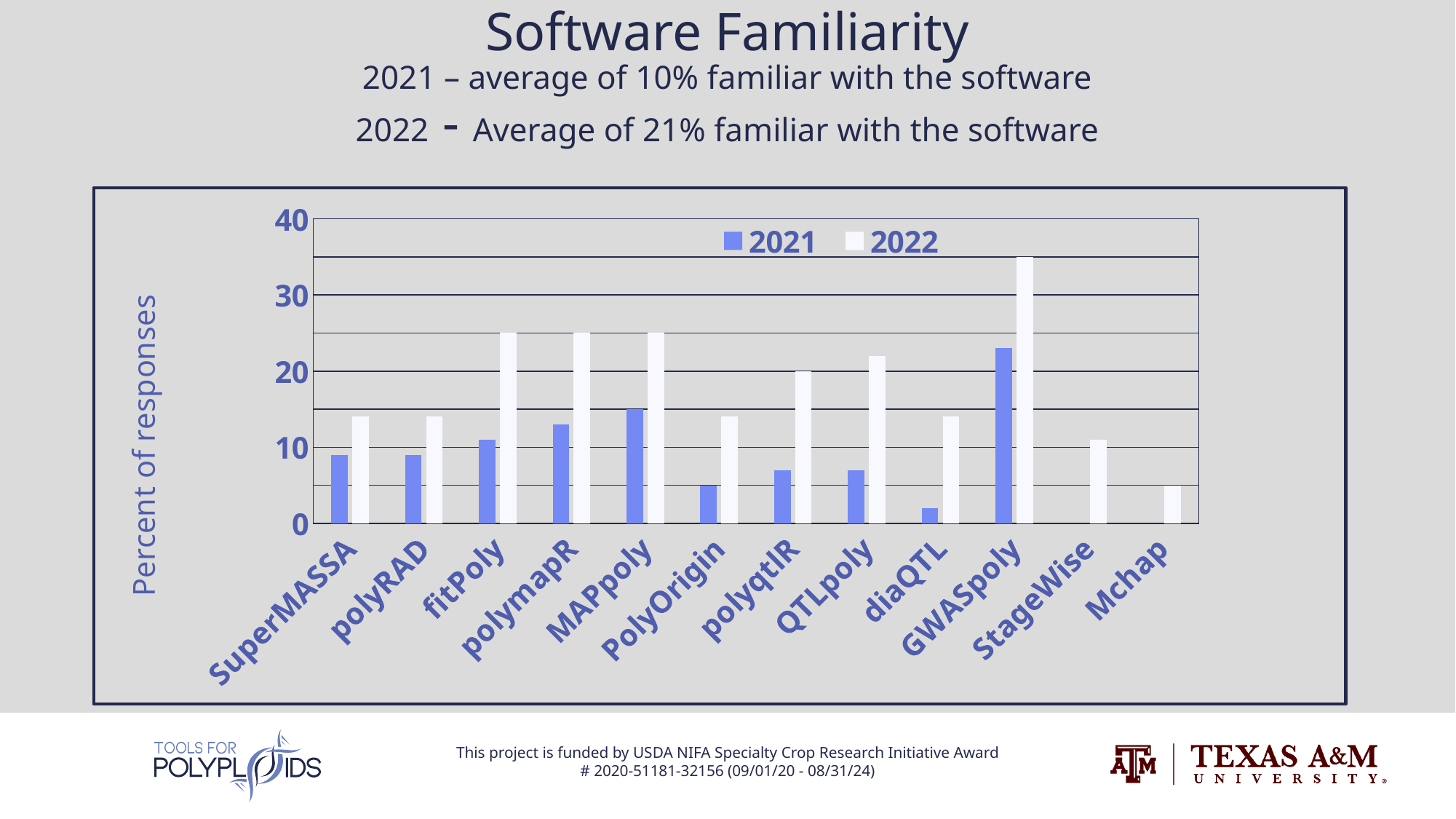
Which software has the highest 2022 value? GWASpoly What kind of chart is shown on the slide? bar chart For polyRAD, which year has the larger value, 2021 or 2022? 2022 Is the 2022 value for GWASpoly greater or less than 30? greater Which software has the lowest 2021 value among those with a 2021 bar? diaQTL What is the 2022 value for polyqtlR? 20 How many series does the legend list? 2 How many software packages are shown on the x axis? 12 What is the label on the y axis? Percent of responses Is the 2022 value for fitPoly greater or less than 20? greater Which software has the highest 2021 value? GWASpoly Is the 2021 value for diaQTL greater or less than 10? less